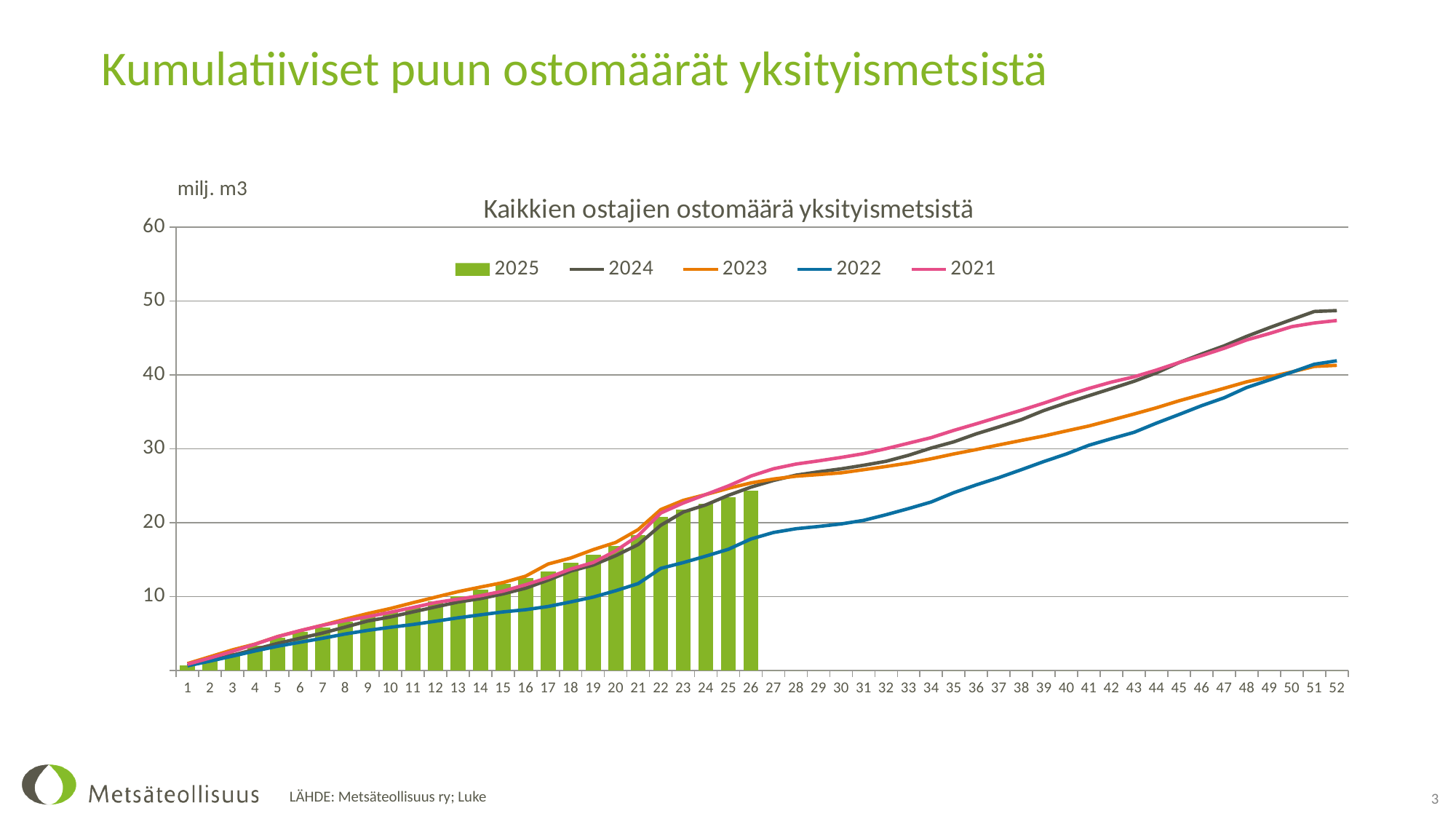
Is the value for 2025 at week 26 greater or less than 20? greater Which series has the lowest value at week 40? 2022 How many series does the legend list? 5 What is the title of the chart? Kaikkien ostajien ostomäärä yksityismetsistä Is the value for 2024 at week 52 greater or less than 40? greater What kind of chart is this? Combined bar and line chart Which series is shown as bars rather than a line? 2025 At week 52, which is larger: the value for 2024 or the value for 2022? 2024 Is the value for 2022 at week 30 greater or less than 30? less How many week categories are shown on the x axis? 52 How many bars are plotted for the 2025 series? 26 Do the values of the 2024 line rise or fall along the x axis? rise